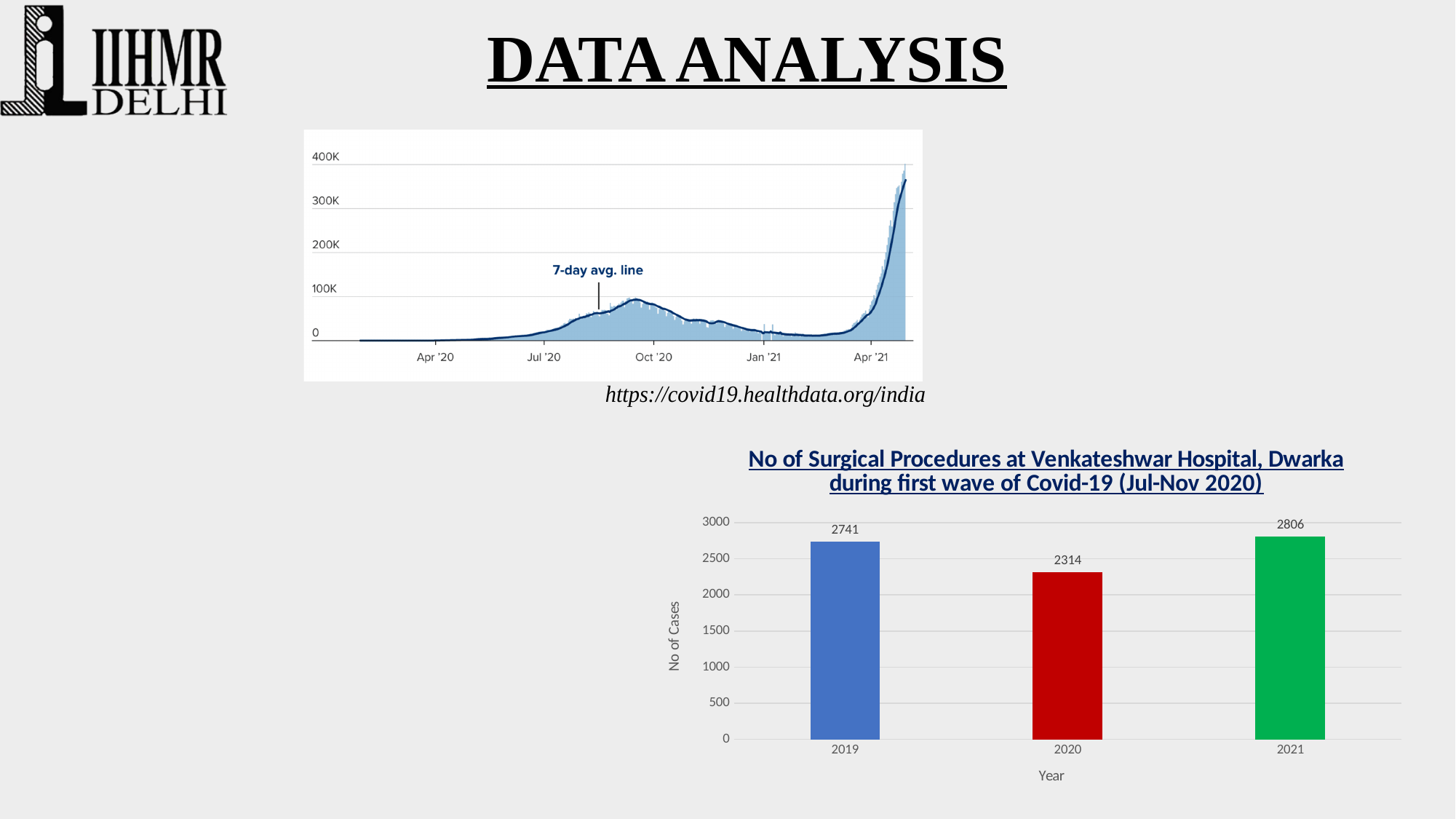
In the bar chart at the bottom of the slide, what is the difference between the number of surgical procedures in 2019 and 2020? 427 In the bar chart at the bottom of the slide, which is larger: the value for 2020 or the value for 2021? 2021 In the bar chart at the bottom of the slide, what is the difference between the number of surgical procedures in 2021 and 2019? 65 In the COVID-19 chart at the top of the slide, is the value of the 7-day average line around Oct '20 greater or less than 200K? less In the COVID-19 chart at the top of the slide, is the peak value of the 7-day average line around Apr '21 greater or less than 300K? greater In the bar chart titled 'No of Surgical Procedures at Venkateshwar Hospital, Dwarka', what is the value for 2019? 2741 How many years are shown in the bar chart at the bottom of the slide? 3 In the bar chart at the bottom of the slide, which year has the highest number of surgical procedures? 2021 In the bar chart at the bottom of the slide, which year has the lowest number of surgical procedures? 2020 In the bar chart titled 'No of Surgical Procedures at Venkateshwar Hospital, Dwarka', what is the value for 2021? 2806 What kind of chart is the chart at the bottom of the slide? Bar chart In the bar chart titled 'No of Surgical Procedures at Venkateshwar Hospital, Dwarka', what is the value for 2020? 2314